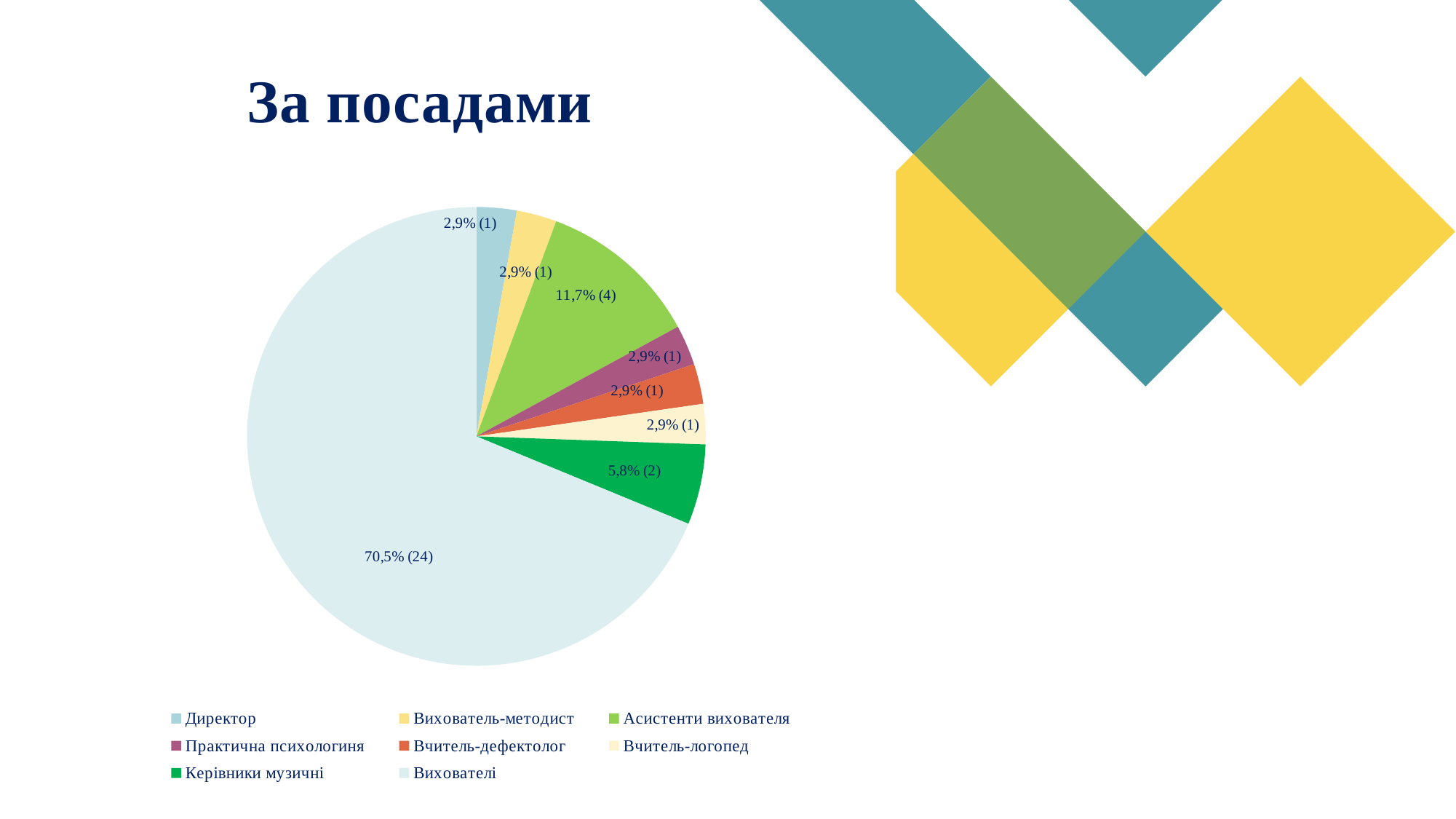
Which category has the largest slice of the pie? Вихователі What share of the pie does Вихователі take? 70,5% What kind of chart is shown on the slide? pie chart What is the title of the chart? За посадами Which is larger, the slice for Керівники музичні or the slice for Вчитель-логопед? Керівники музичні What share of the pie does Керівники музичні take? 5,8% What is the difference in count between Вихователі and Асистенти вихователя? 20 How many categories does the legend of the pie chart list? 8 What share of the pie does Директор take? 2,9% How many people are counted in the Вихователі slice? 24 How many people are counted in the Асистенти вихователя slice? 4